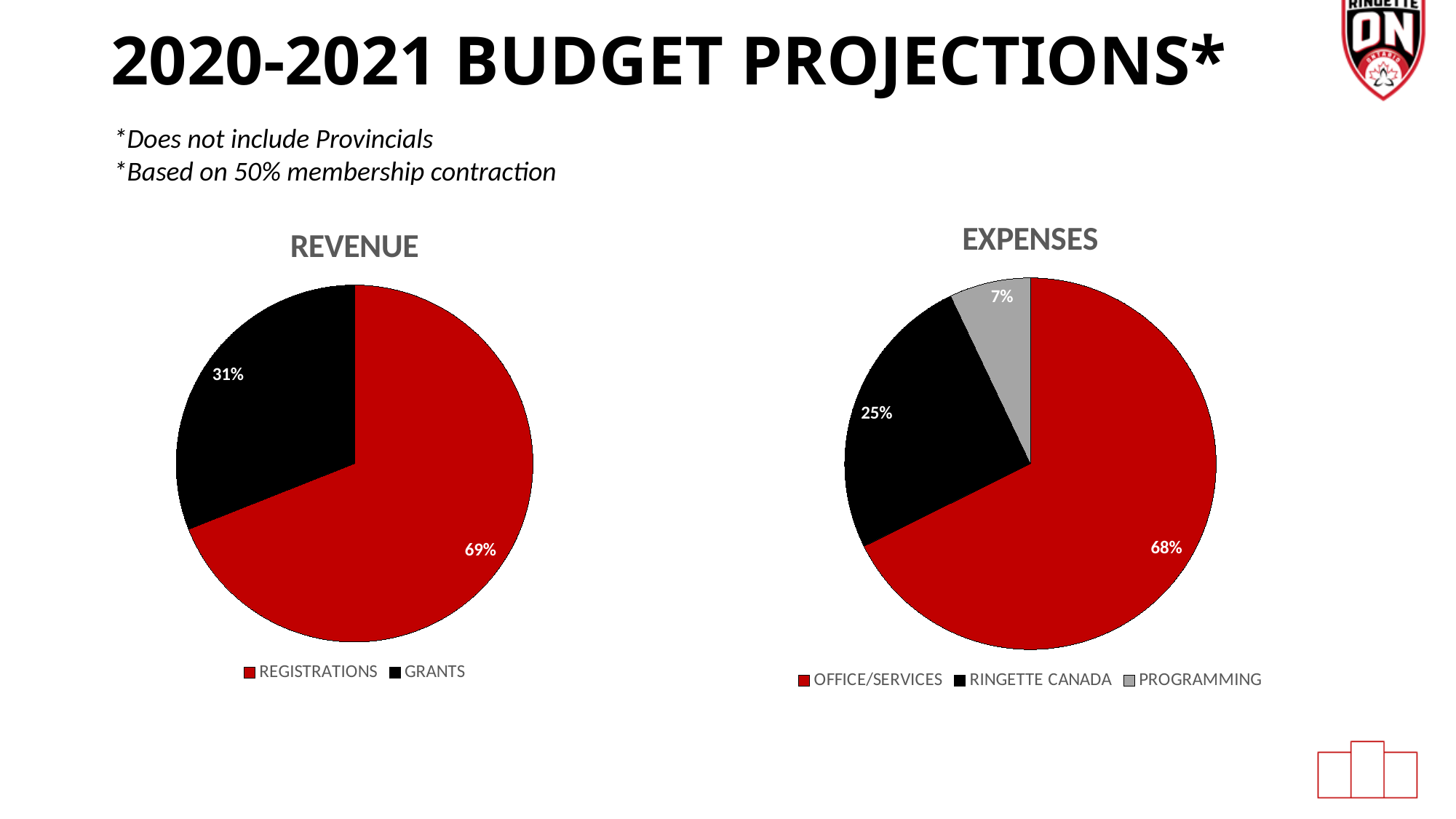
In the EXPENSES chart, what colour is the PROGRAMMING slice? Grey How many categories does the EXPENSES chart show? 3 In the EXPENSES chart, which category has the largest share? OFFICE/SERVICES In the EXPENSES chart, what share of expenses is RINGETTE CANADA? 25% In the EXPENSES chart, what is the difference in percentage points between OFFICE/SERVICES and RINGETTE CANADA? 43 In the EXPENSES chart, which category has the smallest share? PROGRAMMING In the EXPENSES chart, what share of expenses is PROGRAMMING? 7% In the REVENUE chart, which category has the larger share, REGISTRATIONS or GRANTS? REGISTRATIONS In the EXPENSES chart, what share of expenses is OFFICE/SERVICES? 68% What kind of chart is the REVENUE chart? Pie chart